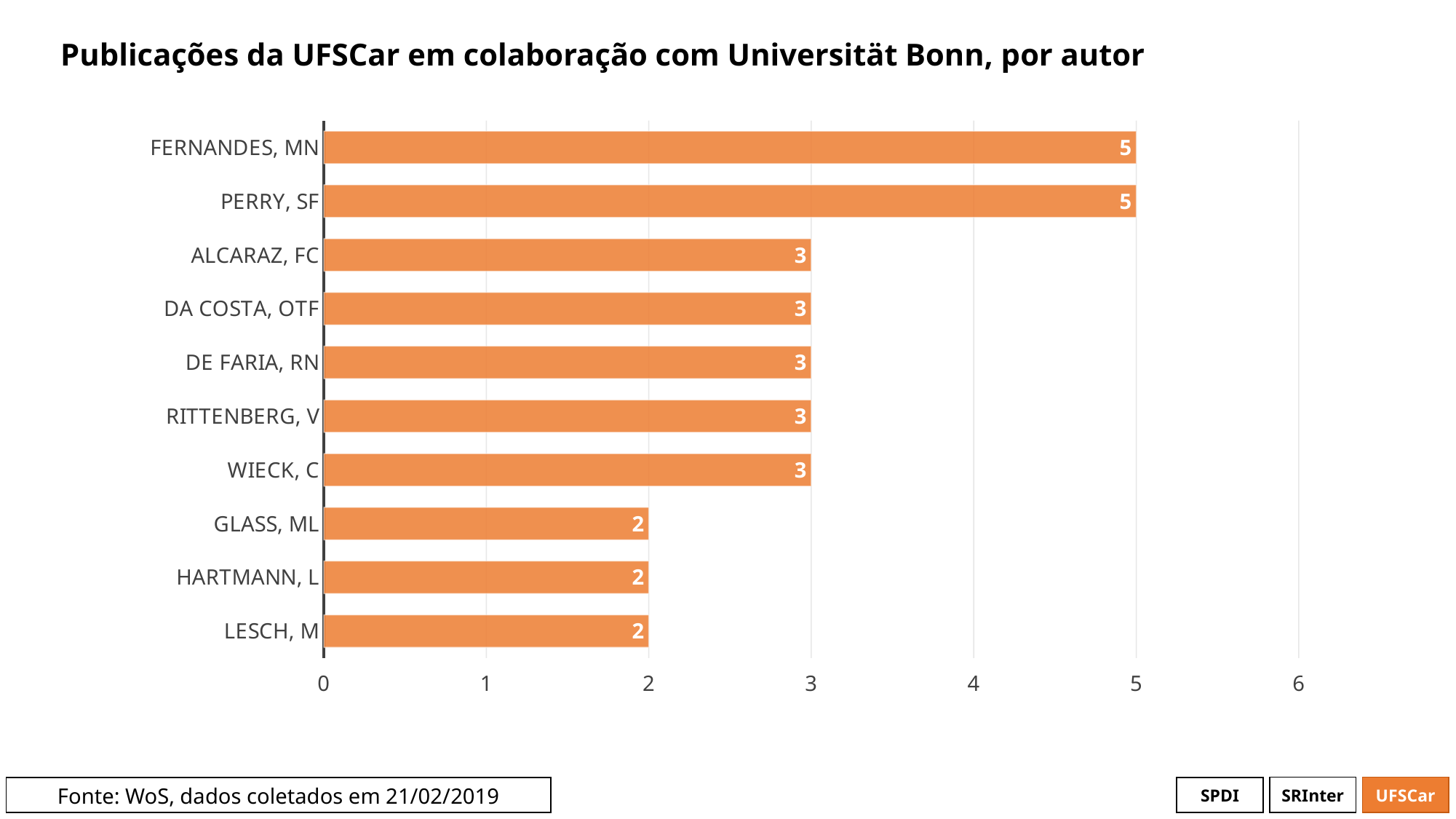
How many authors are shown in the chart? 10 What kind of chart is shown on the slide? bar chart What is the value for HARTMANN, L? 2 What is the title of the chart? Publicações da UFSCar em colaboração com Universität Bonn, por autor What is the value for WIECK, C? 3 What is the difference between the values for ALCARAZ, FC and LESCH, M? 1 What is the difference between the values for PERRY, SF and GLASS, ML? 3 What is the value for DA COSTA, OTF? 3 Which is larger, the value for DE FARIA, RN or the value for GLASS, ML? DE FARIA, RN Is the value for RITTENBERG, V greater or less than 2? greater What is the data source stated on the slide? WoS, dados coletados em 21/02/2019 How many publications does FERNANDES, MN have? 5